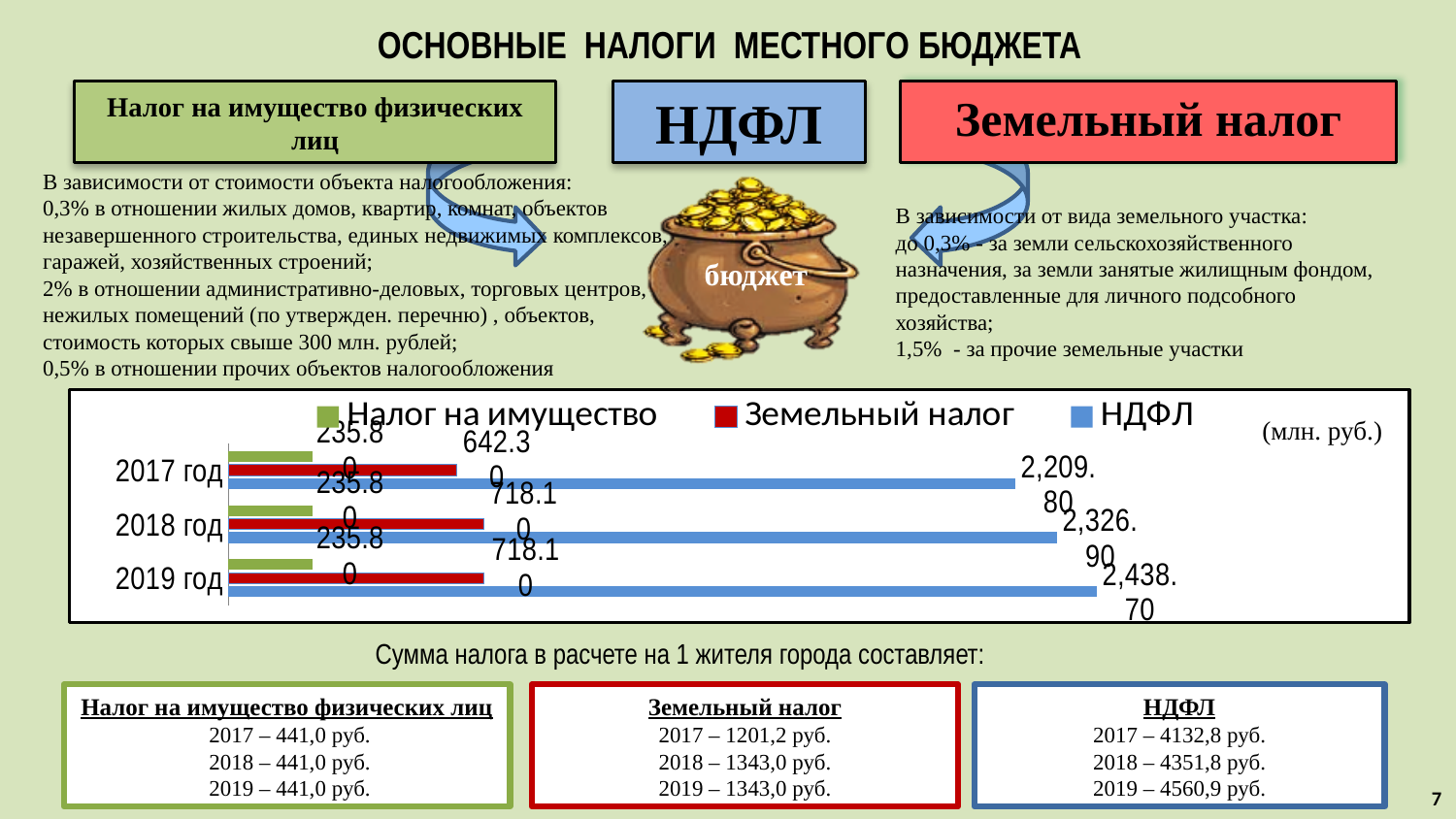
How many years (categories) are shown on the chart? 3 What is the value of Земельный налог for 2017 год? 642.3 What is the value of Налог на имущество for 2017 год? 235.8 What kind of chart is shown on the slide? bar chart By how much did Земельный налог increase from 2017 год to 2018 год? 75.8 In 2017 год, which is larger: Земельный налог or Налог на имущество? Земельный налог Does the value of НДФЛ rise or fall from 2017 год to 2019 год? rise What unit is indicated for the chart values? млн. руб. How many series does the chart legend list? 3 What is the value of Земельный налог for 2019 год? 718.1 Which series has the highest value in 2019 год? НДФЛ What is the value of НДФЛ for 2019 год? 2,438.70